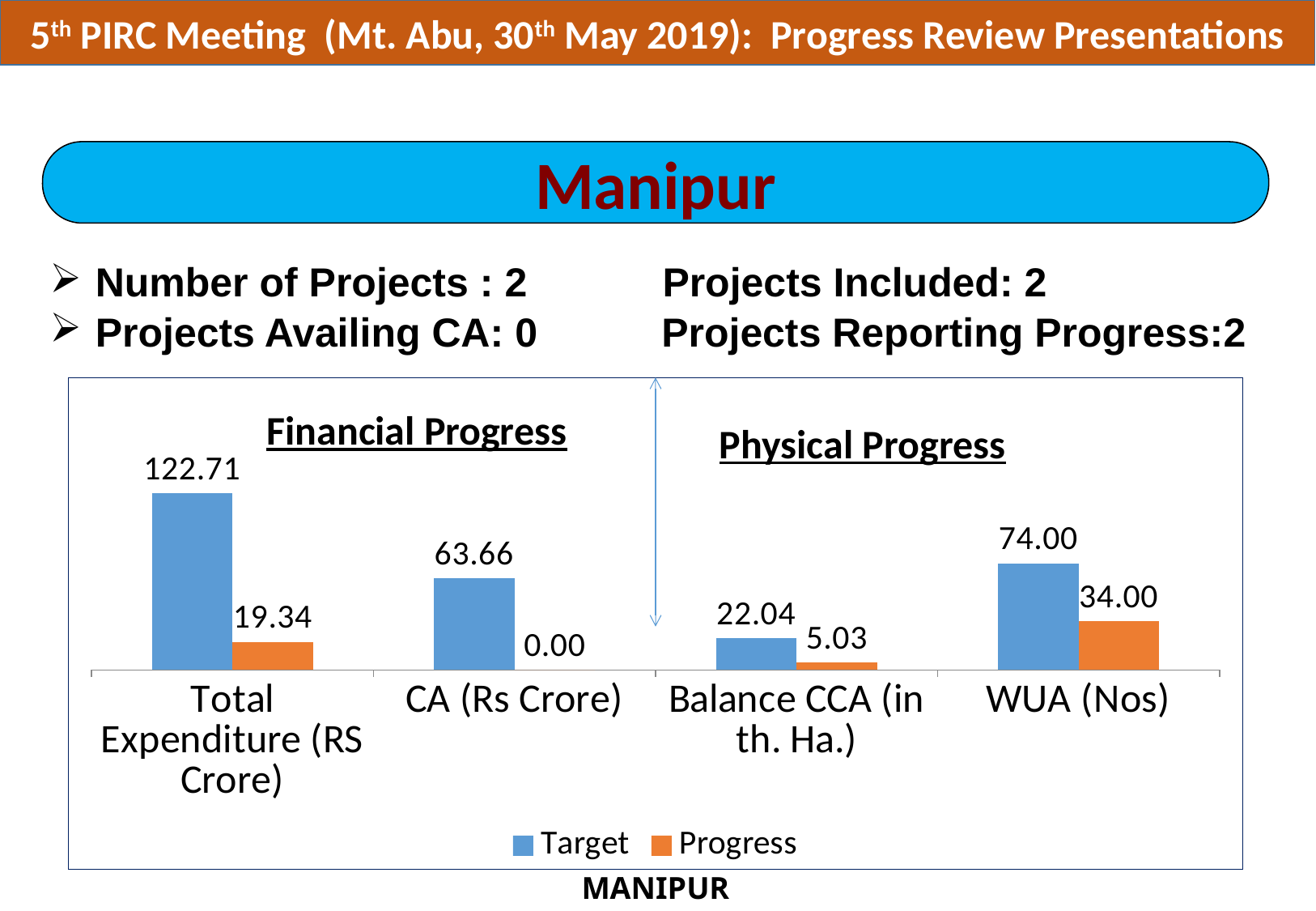
Which category has the lowest Progress value? CA (Rs Crore) What kind of chart is shown on the slide? Bar chart What is the Progress value for Total Expenditure (RS Crore)? 19.34 What is the Progress value for Balance CCA (in th. Ha.)? 5.03 What is the difference between the Target and Progress values for WUA (Nos)? 40.00 Which is larger: the Target value for CA (Rs Crore) or the Target value for Balance CCA (in th. Ha.)? CA (Rs Crore) What is the Progress value for CA (Rs Crore)? 0.00 How many series does the legend list? 2 What is the Target value for Total Expenditure (RS Crore)? 122.71 What is the Target value for WUA (Nos)? 74.00 How many categories are shown on the x axis? 4 Which category has the highest Target value? Total Expenditure (RS Crore)